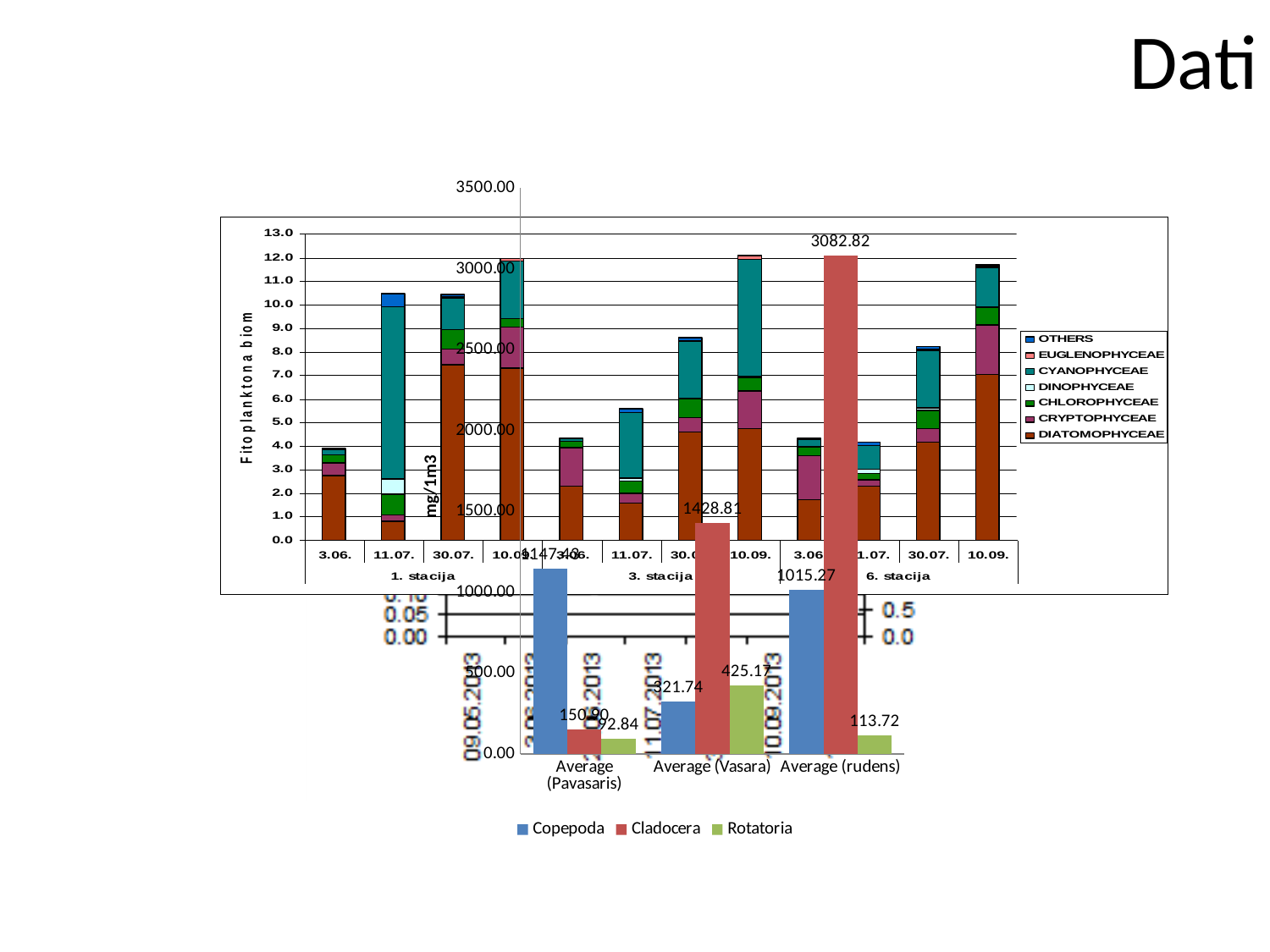
In the phytoplankton chart (Fitoplanktona biom), is the total of the 3.06. bar for 1. stacija greater or less than 5.0? less In the bottom chart with the Copepoda, Cladocera and Rotatoria legend, what is the Cladocera value for Average (rudens)? 3082.82 How many stacked bars are plotted in the phytoplankton chart (Fitoplanktona biom)? 12 In the bottom chart with the Copepoda, Cladocera and Rotatoria legend, which category has the highest Cladocera value? Average (rudens) In the bottom chart with the Copepoda, Cladocera and Rotatoria legend, what is the difference between the Cladocera values for Average (rudens) and Average (Vasara)? 1654.01 In the bottom chart with the Copepoda, Cladocera and Rotatoria legend, what is the Rotatoria value for Average (Vasara)? 425.17 In the bottom chart with the Copepoda, Cladocera and Rotatoria legend, which is larger: the Rotatoria value for Average (Vasara) or for Average (rudens)? Average (Vasara) In the bottom chart with the Copepoda, Cladocera and Rotatoria legend, what is the Cladocera value for Average (Vasara)? 1428.81 How many series does the legend of the bottom chart (Copepoda, Cladocera, Rotatoria) list? 3 In the bottom chart with the Copepoda, Cladocera and Rotatoria legend, what is the Copepoda value for Average (rudens)? 1015.27 In the bottom chart with the Copepoda, Cladocera and Rotatoria legend, what is the Rotatoria value for Average (rudens)? 113.72 How many series does the legend of the stacked phytoplankton chart (Fitoplanktona biom) list? 7